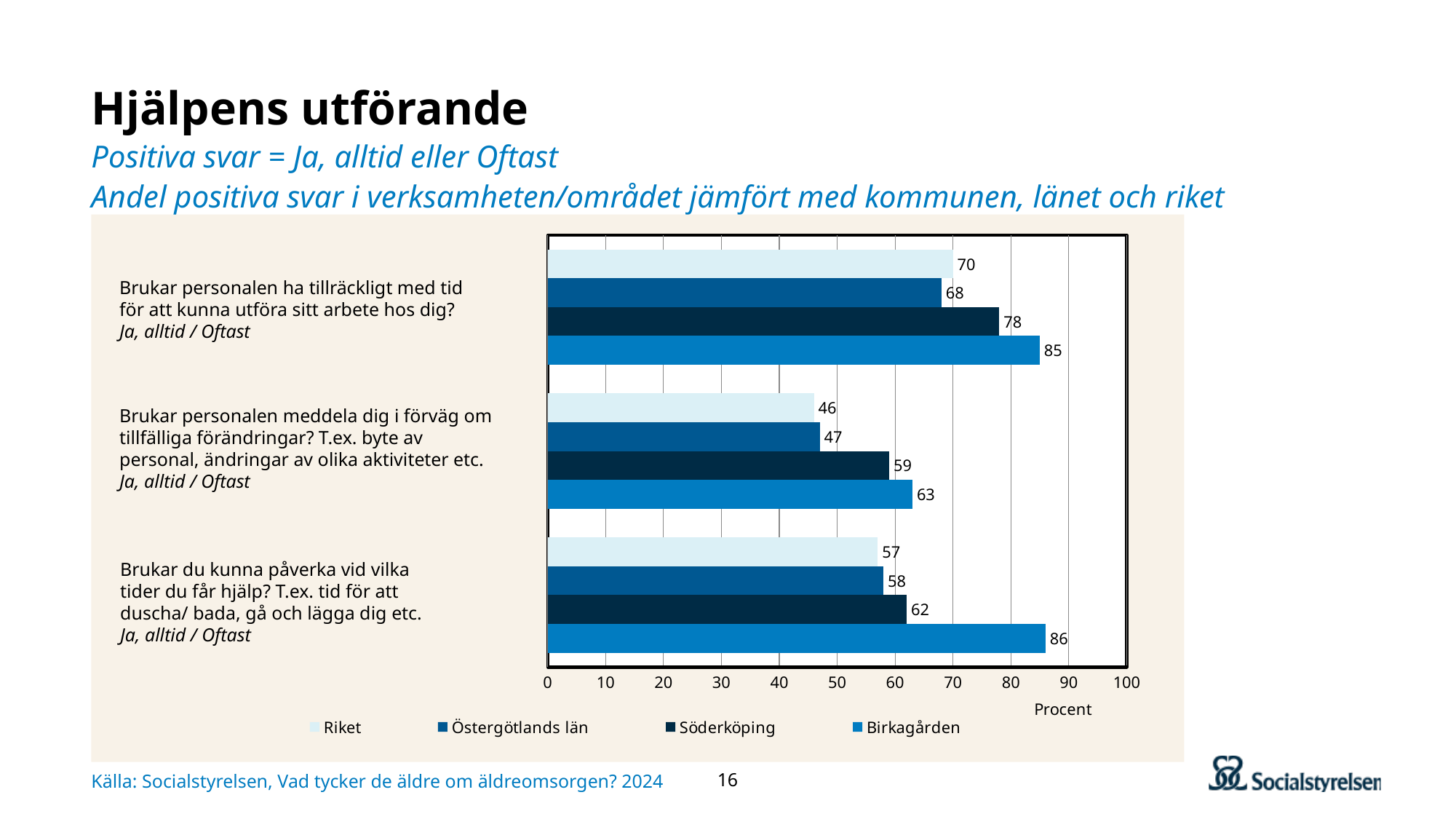
Which series has the highest value on the question "Brukar du kunna påverka vid vilka tider du får hjälp?"? Birkagården What is the difference between Birkagården and Riket on the question "Brukar du kunna påverka vid vilka tider du får hjälp?"? 29 What is the value for Birkagården on the question "Brukar personalen ha tillräckligt med tid för att kunna utföra sitt arbete hos dig?"? 85 How many series does the legend list? 4 What is the value for Riket on the question "Brukar personalen meddela dig i förväg om tillfälliga förändringar?"? 46 What is the difference between Söderköping and Östergötlands län on the question "Brukar personalen ha tillräckligt med tid för att kunna utföra sitt arbete hos dig?"? 10 Which series has the lowest value on the question "Brukar personalen meddela dig i förväg om tillfälliga förändringar?"? Riket How many question categories are shown in the chart? 3 Which is larger: Birkagården's value on "Brukar personalen meddela dig i förväg om tillfälliga förändringar?" or Riket's value on "Brukar personalen ha tillräckligt med tid för att kunna utföra sitt arbete hos dig?"? Riket's value on "Brukar personalen ha tillräckligt med tid" (70) What kind of chart is shown on the slide? Bar chart What is the value for Söderköping on the question "Brukar du kunna påverka vid vilka tider du får hjälp?"? 62 What unit is shown on the x axis of the chart? Procent